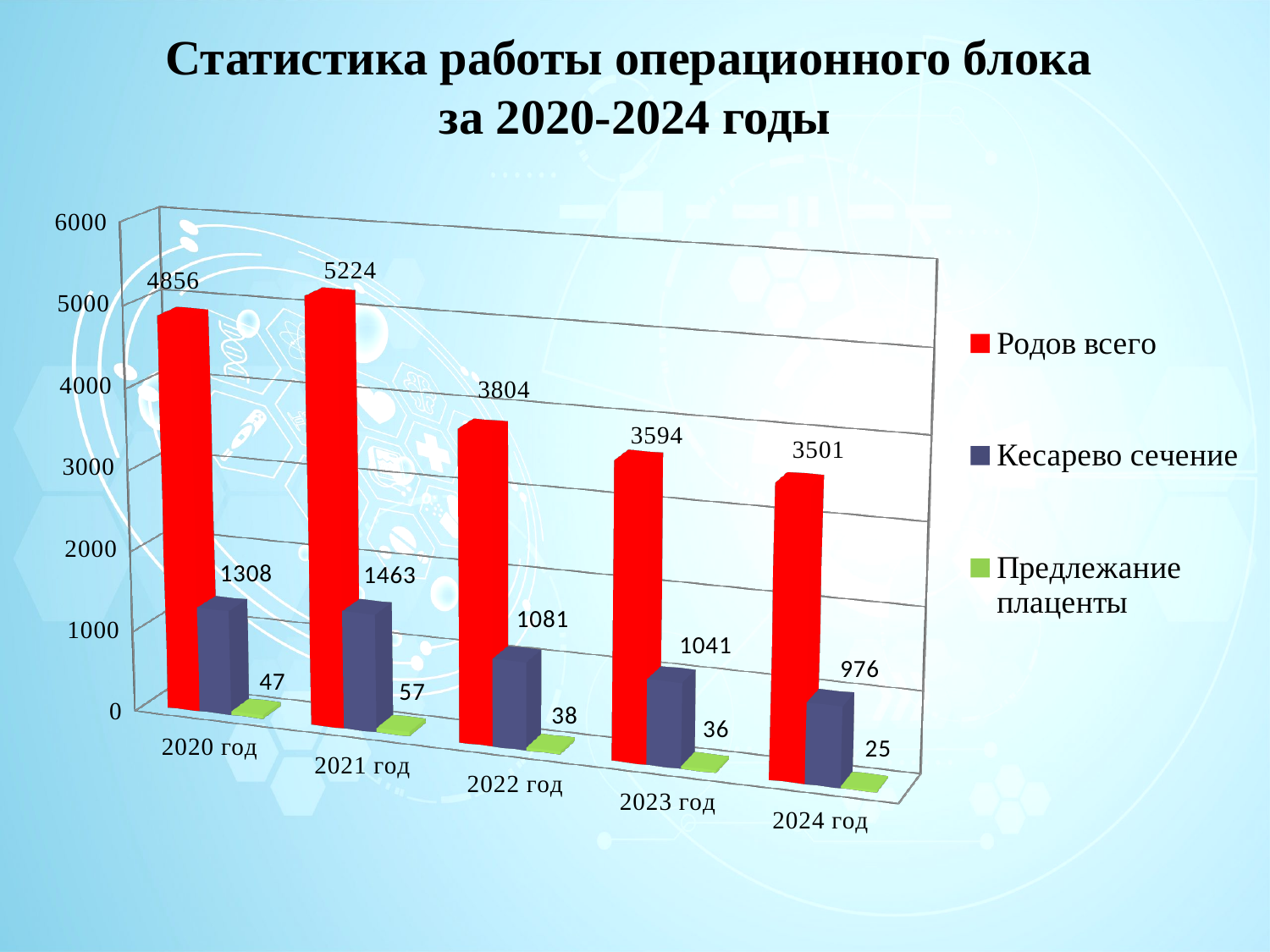
Which year has the highest value for Родов всего? 2021 год What is the value of Предлежание плаценты for 2024 год? 25 What kind of chart is shown on the slide? bar chart Is the value for Родов всего in 2022 год greater or less than 4000? less Does the value for Предлежание плаценты rise or fall from 2021 год to 2024 год? fall What is the value of Кесарево сечение for 2023 год? 1041 What is the value of Родов всего for 2021 год? 5224 Which is larger: Кесарево сечение in 2020 год or in 2022 год? 2020 год Which year has the lowest value for Кесарево сечение? 2024 год How many series does the legend list? 3 What is the difference between Родов всего in 2020 год and 2024 год? 1355 How many years are shown on the x axis? 5